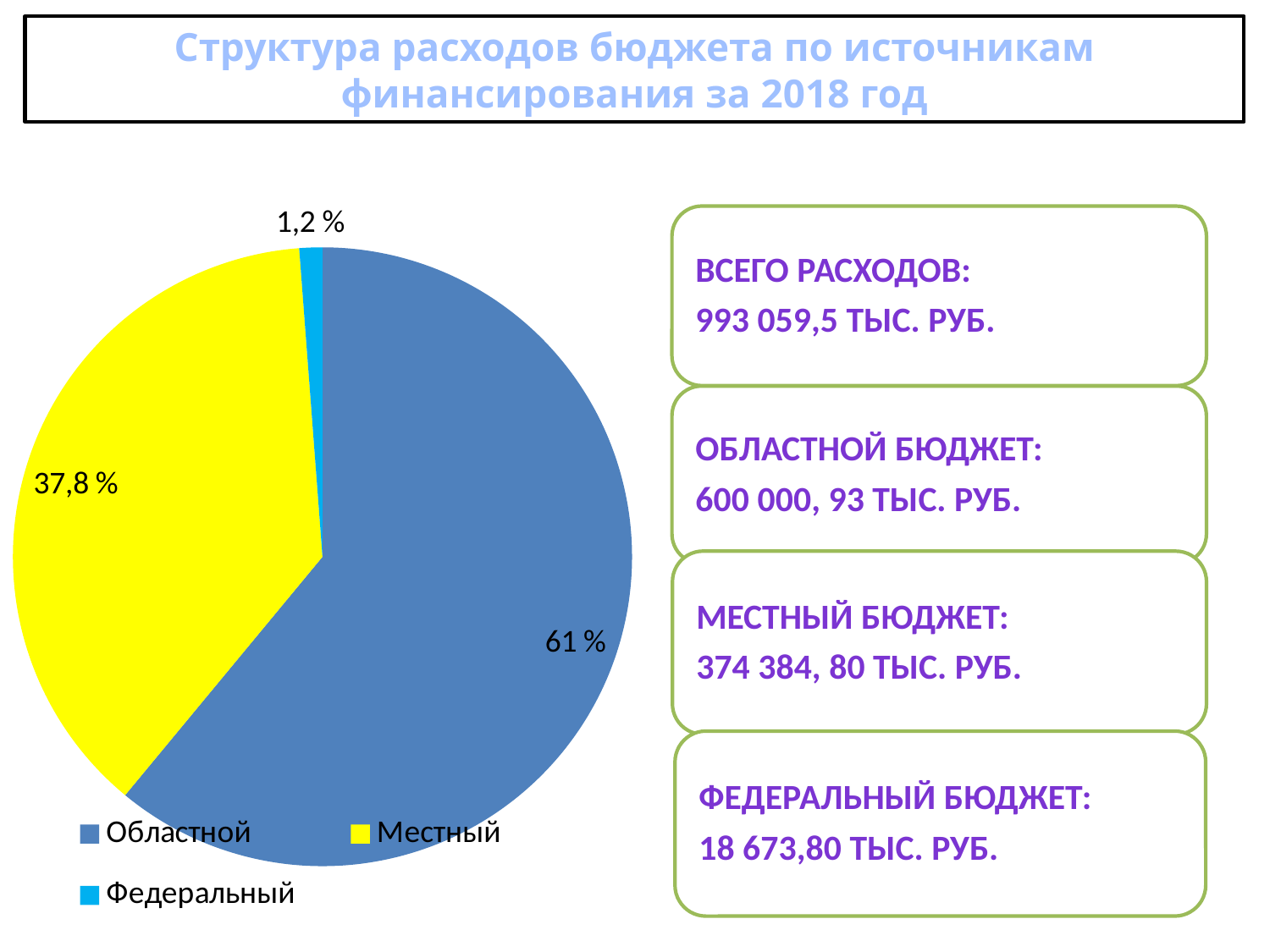
Which category has the smallest slice of the pie? Федеральный What is the difference between the Областной and Местный shares? 23,2 % Which category has the largest slice of the pie? Областной How many slices does the pie chart have? 3 What is the value shown for the Федеральный slice? 1,2 % Which is larger, the Местный slice or the Федеральный slice? Местный How many entries does the legend list? 3 What is the difference between the Местный and Федеральный shares? 36,6 % What share of the pie does the Областной slice represent? 61 % What type of chart is shown on the slide? pie chart What share of the pie does the Местный slice represent? 37,8 % What colour is the Местный slice in the pie chart? yellow